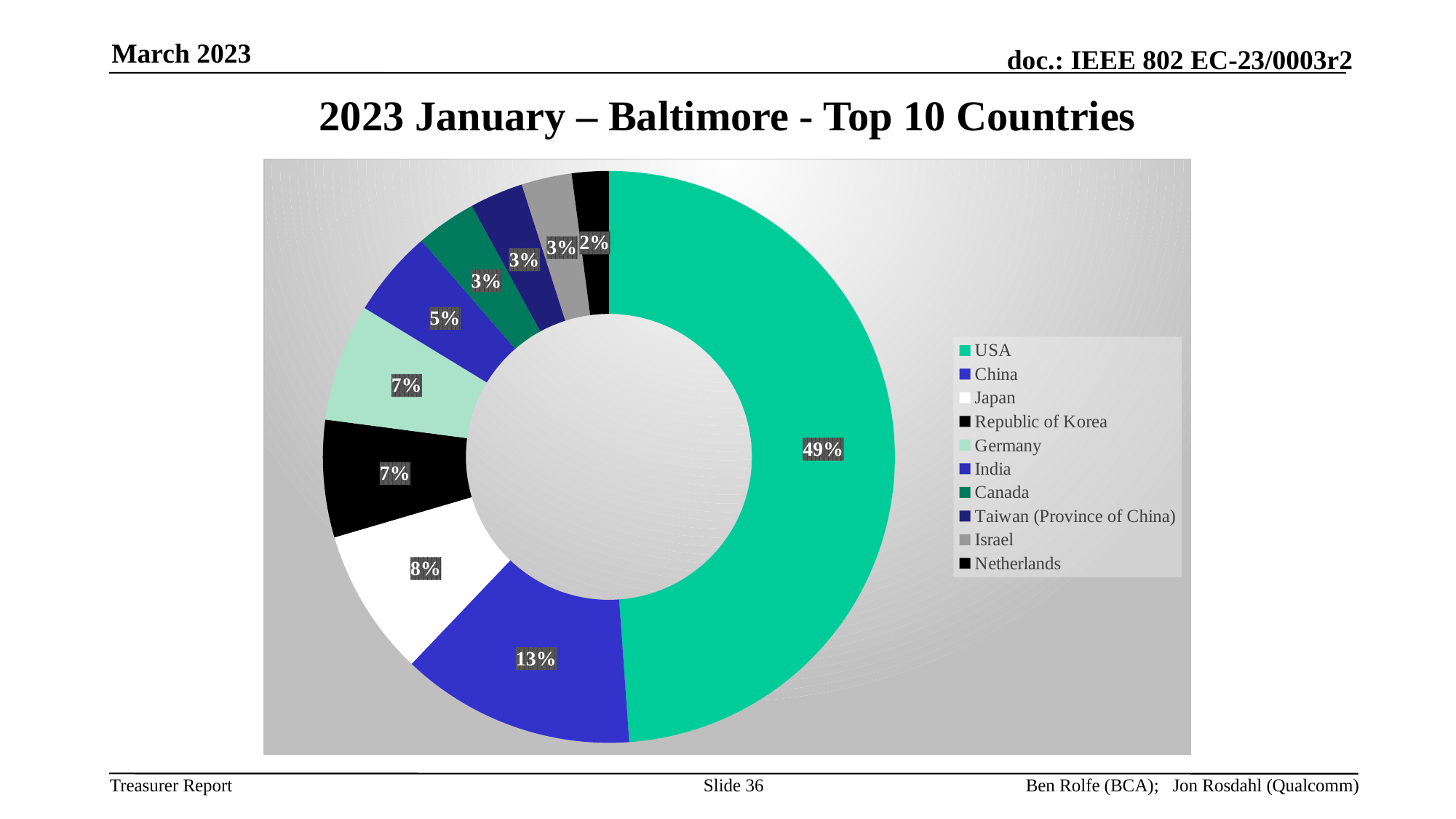
What share of the chart does USA account for? 49% What kind of chart is shown on the slide? doughnut chart What is the value shown for Japan? 8% Which country has the smallest share in the chart? Netherlands What is the value shown for China? 13% How many countries are shown in the chart? 10 Which country has the largest share in the chart? USA Which has the larger share, Japan or India? Japan What is the title of the chart? 2023 January – Baltimore - Top 10 Countries What is the value shown for India? 5% What is the value shown for Netherlands? 2% What is the difference between the shares of USA and China? 36 percentage points